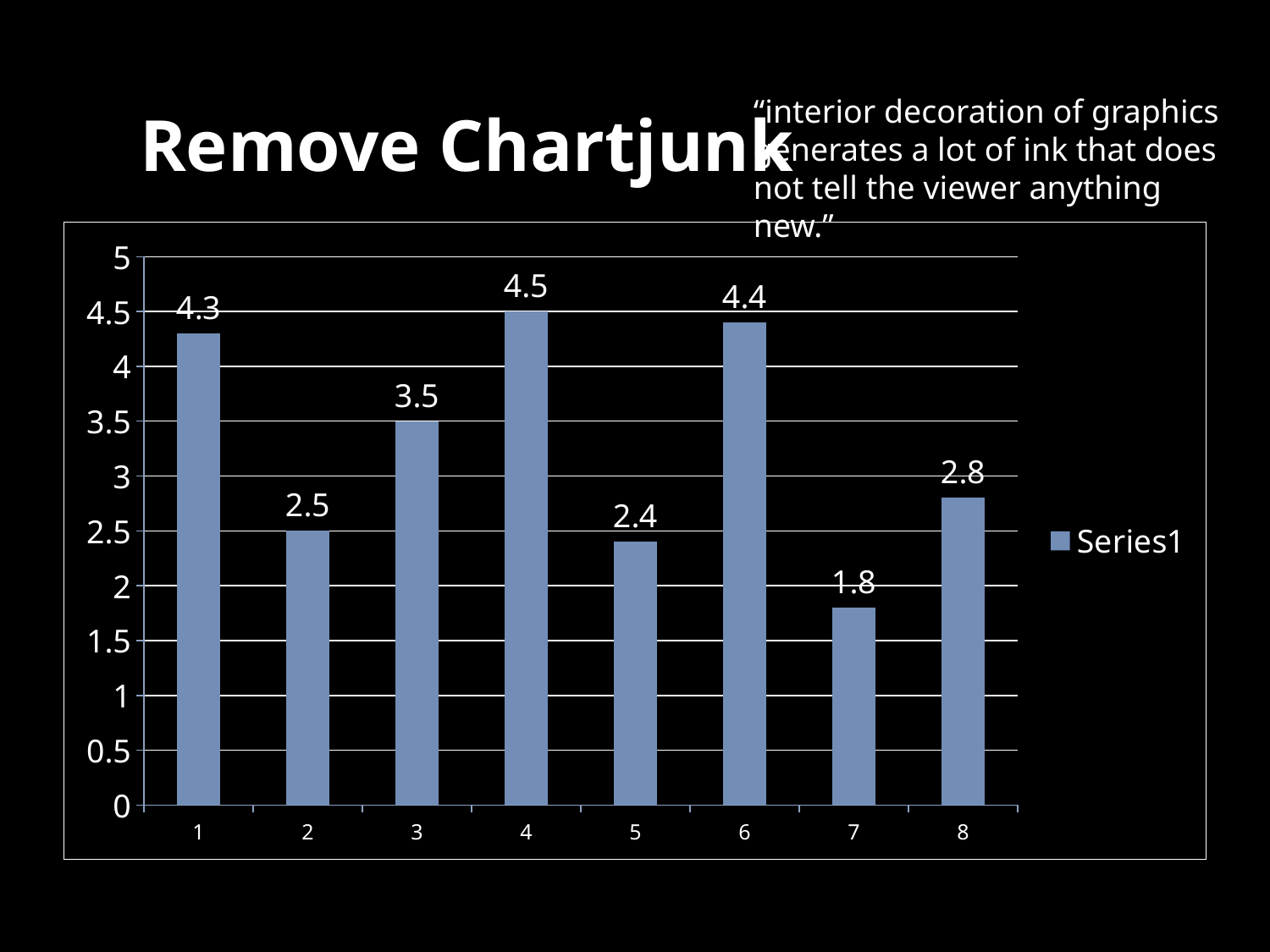
Which category has the lowest value? 7 How many categories are shown on the x axis? 8 What is the difference between the values for category 4 and category 7? 2.7 What kind of chart is shown on the slide? bar chart What is the value for category 7? 1.8 Is the value for category 6 greater or less than 4? greater Which is larger, the value for category 3 or the value for category 8? category 3 What is the value for category 5? 2.4 What is the value for category 1? 4.3 How many series does the legend list? 1 Which category has the highest value? 4 What is the difference between the values for category 1 and category 2? 1.8